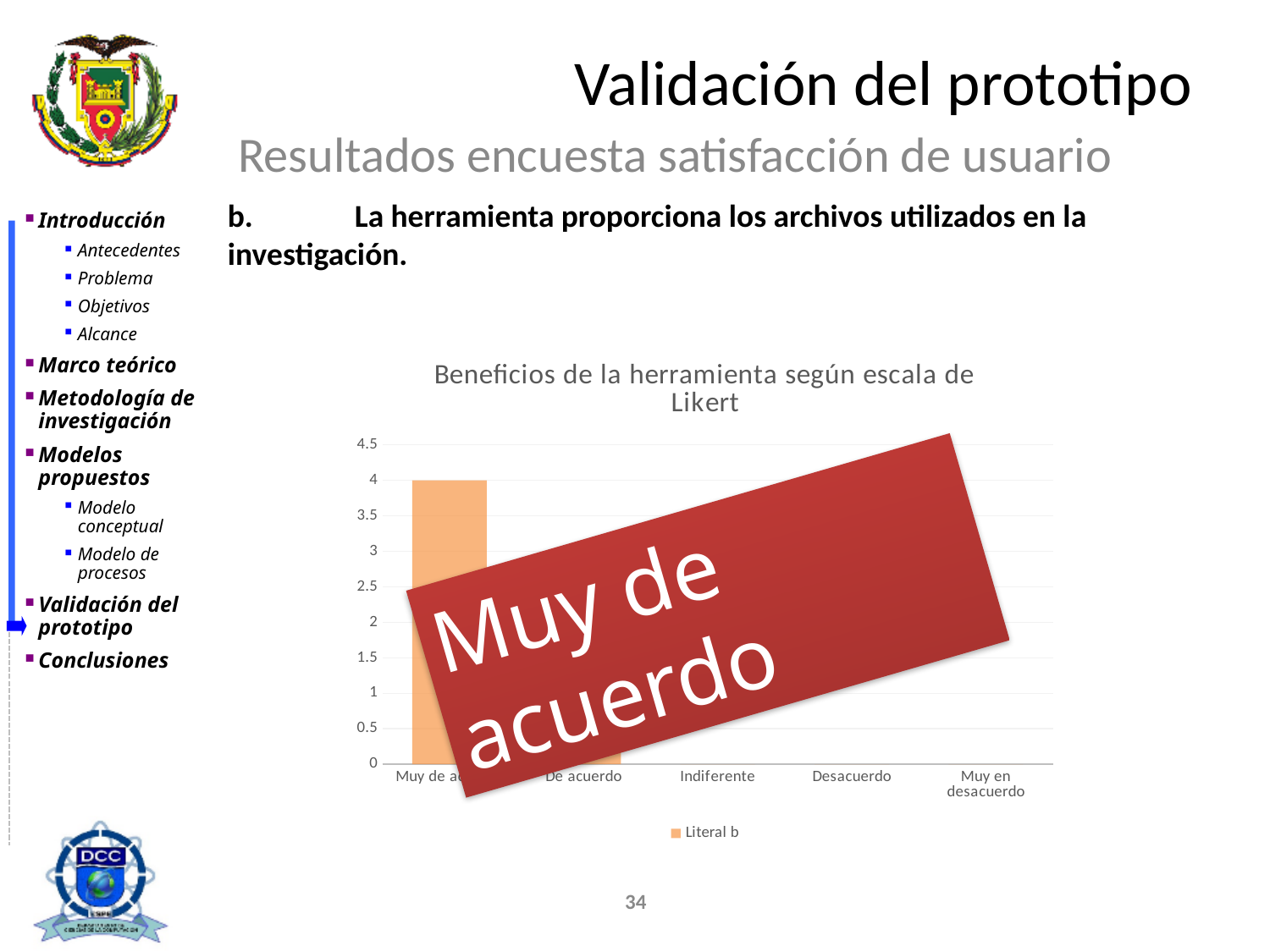
What kind of chart is shown on the slide? bar chart How many categories are shown on the x axis of the chart? 5 Is the value for 'Muy de acuerdo' greater or less than 3? greater What is the name of the series shown in the legend? Literal b How many series does the chart legend list? 1 What is the value for 'Muy de acuerdo' in the chart? 4 What is the highest value shown on the y axis of the chart? 4.5 What is the title of the chart? Beneficios de la herramienta según escala de Likert Which category has the highest value in the chart? Muy de acuerdo Is the value for 'Muy de acuerdo' greater or less than 4.5? less